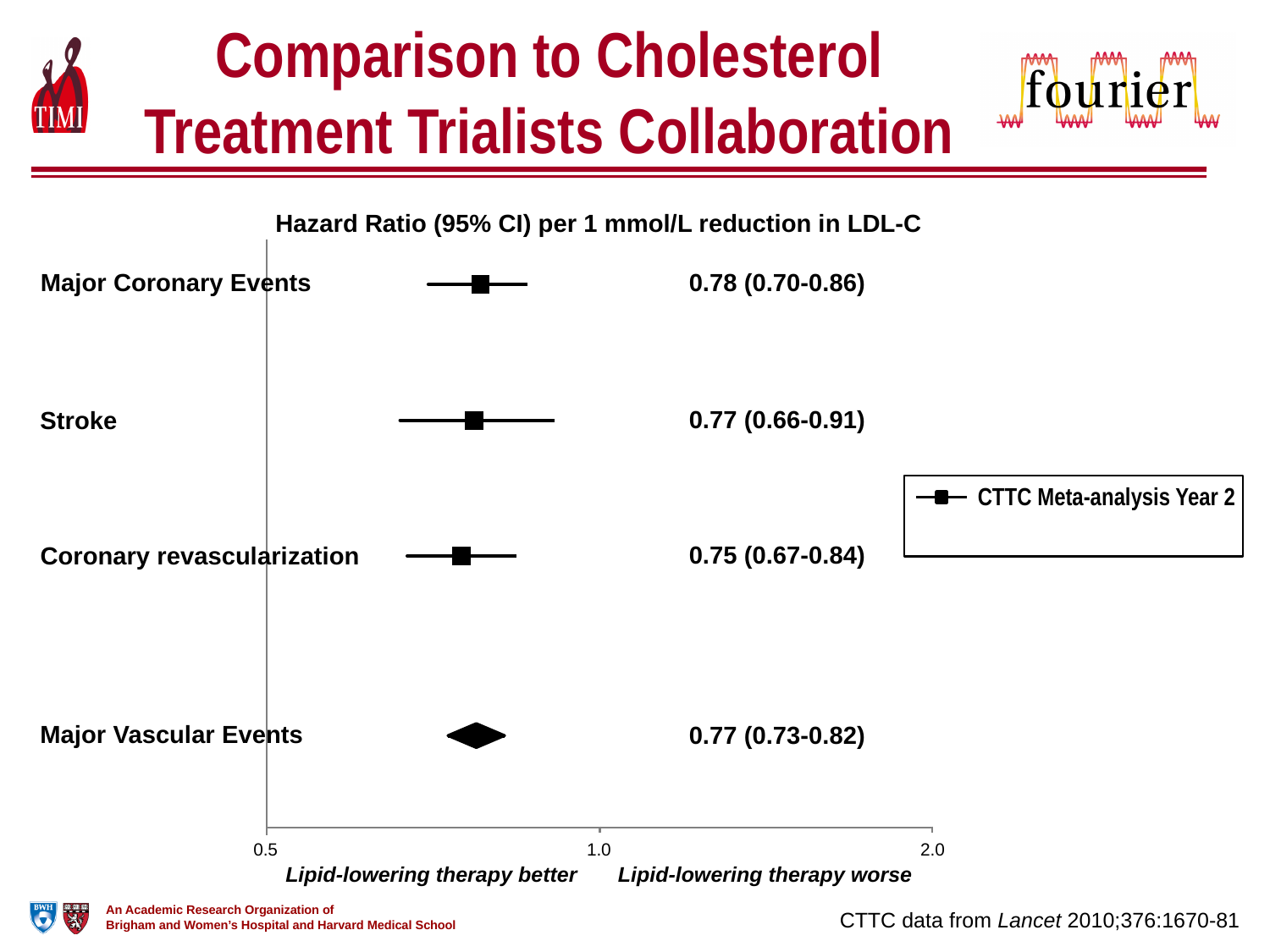
How many series does the legend list? 1 What is the hazard ratio (95% CI) for Stroke? 0.77 (0.66-0.91) Which outcome has the highest point-estimate hazard ratio? Major Coronary Events What is the hazard ratio (95% CI) for Major Vascular Events? 0.77 (0.73-0.82) What kind of chart is shown on the slide? Forest plot What is the hazard ratio (95% CI) for Coronary revascularization? 0.75 (0.67-0.84) Which outcome has the lowest point-estimate hazard ratio? Coronary revascularization Is the hazard ratio point estimate for Stroke greater or less than 1.0? less What is the difference between the hazard ratio point estimates for Major Coronary Events and Coronary revascularization? 0.03 What is the hazard ratio (95% CI) for Major Coronary Events? 0.78 (0.70-0.86) How many outcomes are plotted in the chart? 4 What is the series name shown in the legend? CTTC Meta-analysis Year 2